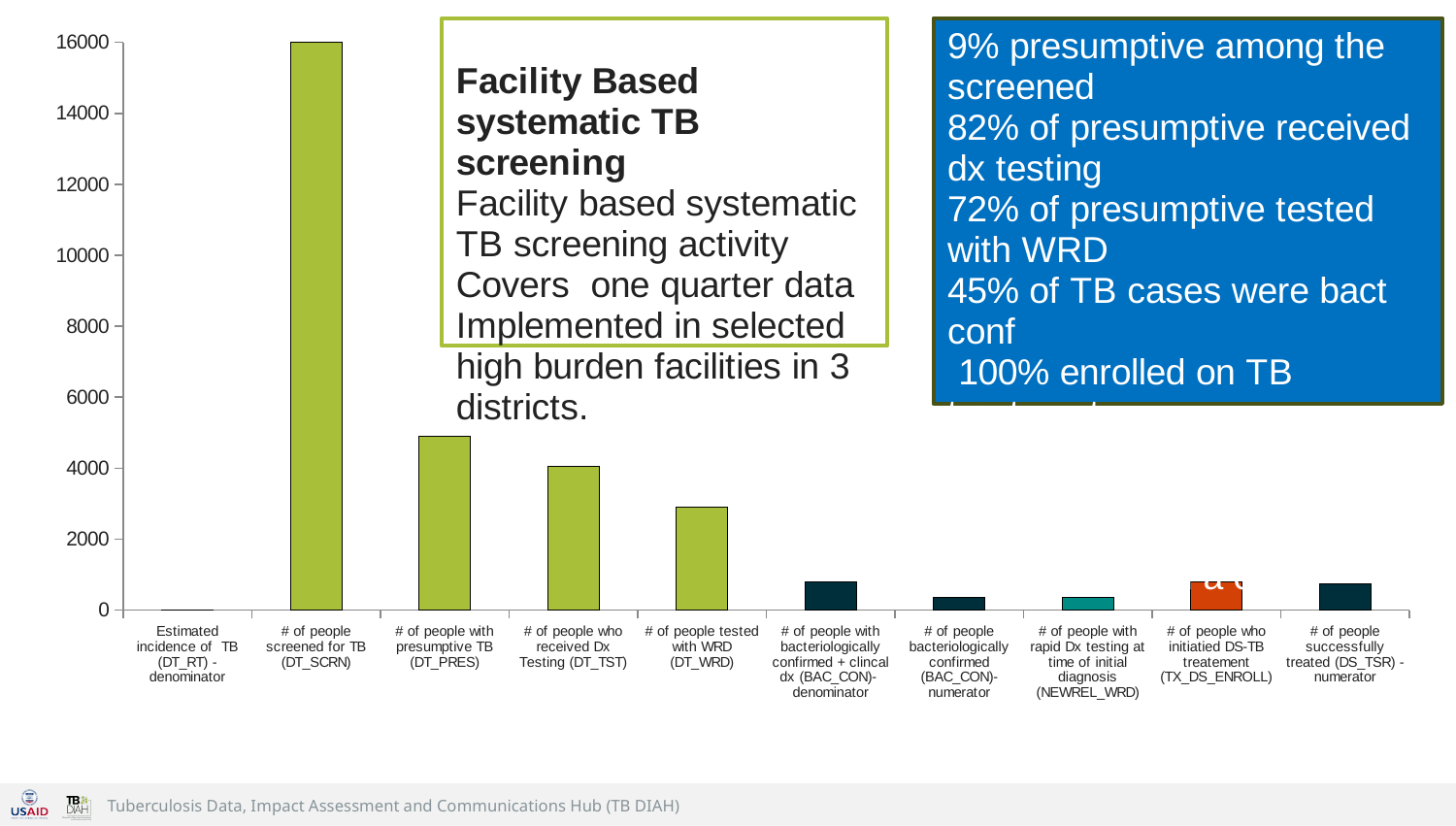
How many categories are plotted along the x axis of the chart? 10 Is the value for '# of people screened for TB (DT_SCRN)' greater or less than 14000? greater Which category has the highest value in the chart? # of people screened for TB (DT_SCRN) What colour is the bar for '# of people who initiated DS-TB treatement (TX_DS_ENROLL)'? orange Is the value for '# of people with presumptive TB (DT_PRES)' greater or less than 4000? greater Is the value for '# of people tested with WRD (DT_WRD)' greater or less than 2000? greater Do the values rise or fall moving from '# of people screened for TB (DT_SCRN)' to '# of people tested with WRD (DT_WRD)'? fall What kind of chart is shown on the slide? bar chart Which is larger: the value for '# of people with presumptive TB (DT_PRES)' or '# of people who received Dx Testing (DT_TST)'? # of people with presumptive TB (DT_PRES) Which category has the lowest value in the chart? Estimated incidence of TB (DT_RT) - denominator